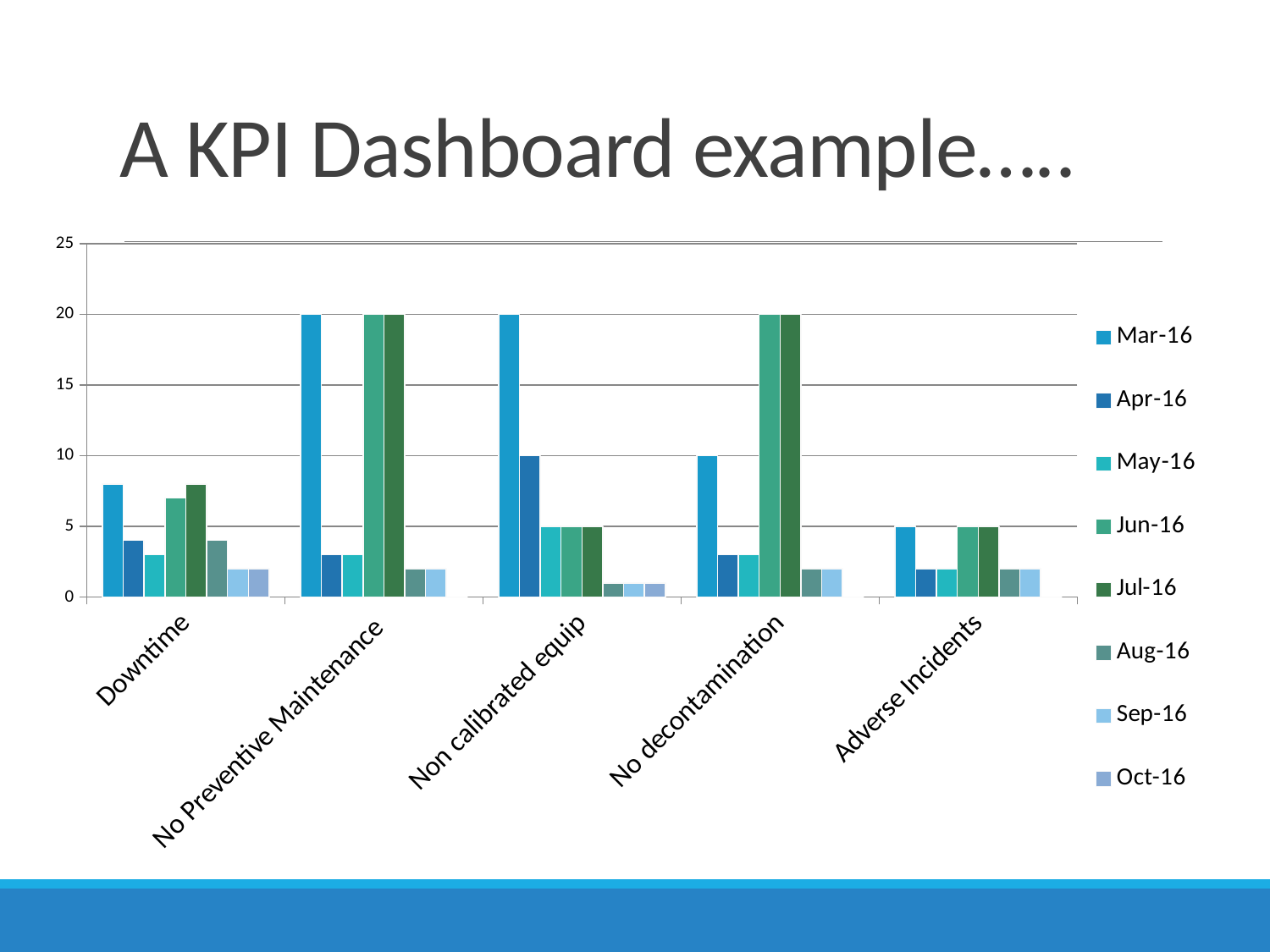
What is the title of the slide containing the chart? A KPI Dashboard example….. What is the value for Mar-16 in the No decontamination category? 10 What is the value for Apr-16 in the Non calibrated equip category? 10 Is the value for Mar-16 in the Downtime category greater or less than 5? greater What is the value for Mar-16 in the No Preventive Maintenance category? 20 What kind of chart is shown on the slide? bar chart In the No decontamination category, which is larger: the Mar-16 value or the Jun-16 value? Jun-16 How many categories are shown on the x axis? 5 Is the value for Aug-16 in the Non calibrated equip category greater or less than 5? less What is the value for Jun-16 in the Adverse Incidents category? 5 How many series does the legend list? 8 Which series has the highest value in the Non calibrated equip category? Mar-16